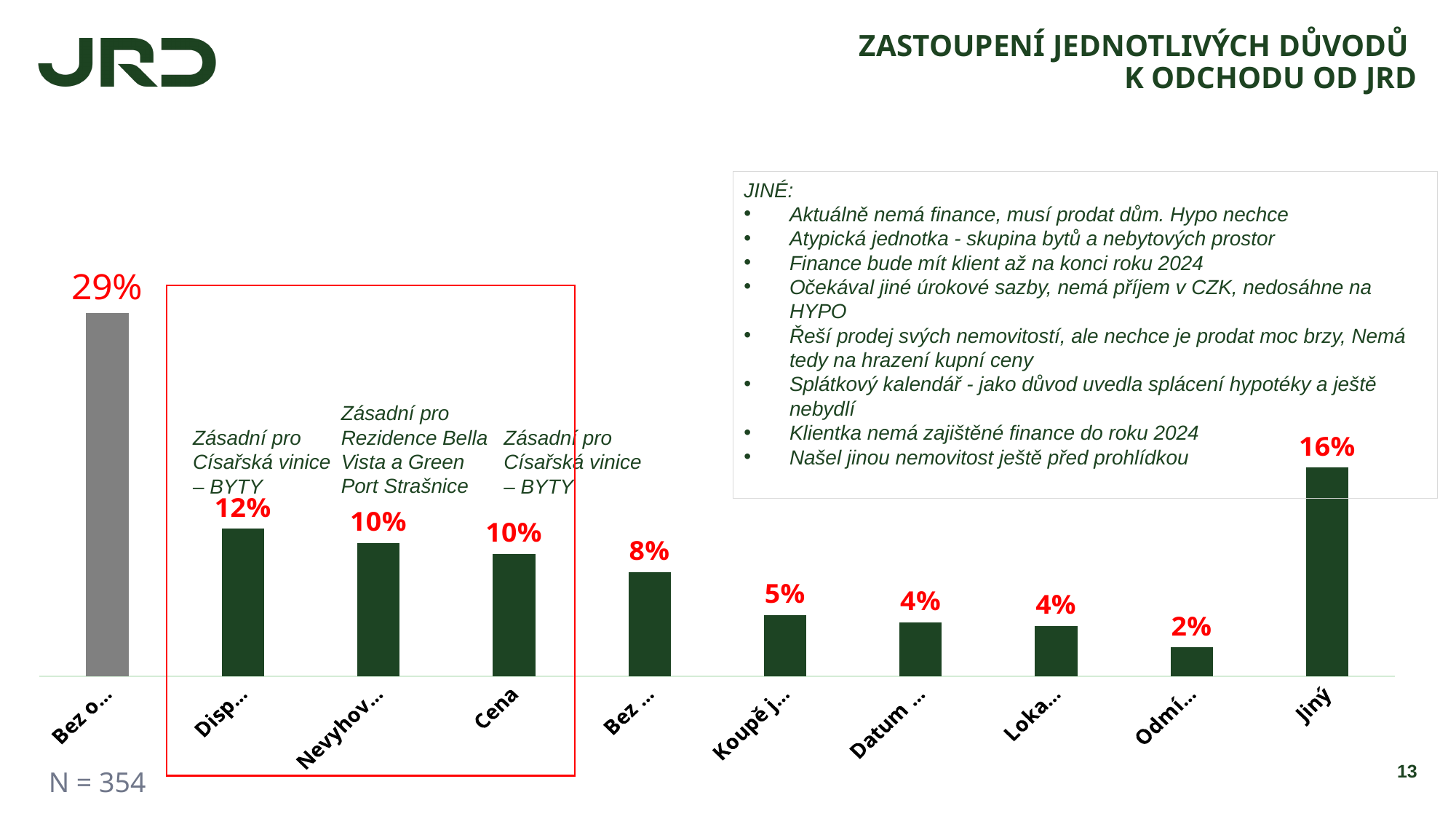
How many bars are plotted on the chart? 10 Which has a larger value, "Jiný" or "Cena"? Jiný How many bars are enclosed by the red rectangle on the chart? 3 What is the sample size (N) stated on the slide? N = 354 What is the highest value shown on the chart? 29% What is the title of the slide? Zastoupení jednotlivých důvodů k odchodu od JRD What is the lowest value shown on the chart? 2% What is the difference between the highest value on the chart and the value for "Jiný"? 13% What is the value shown for the category "Cena"? 10% What kind of chart is shown on the slide? Bar chart What is the value shown for the category "Jiný"? 16% What is the difference between the values for "Jiný" and "Cena"? 6%